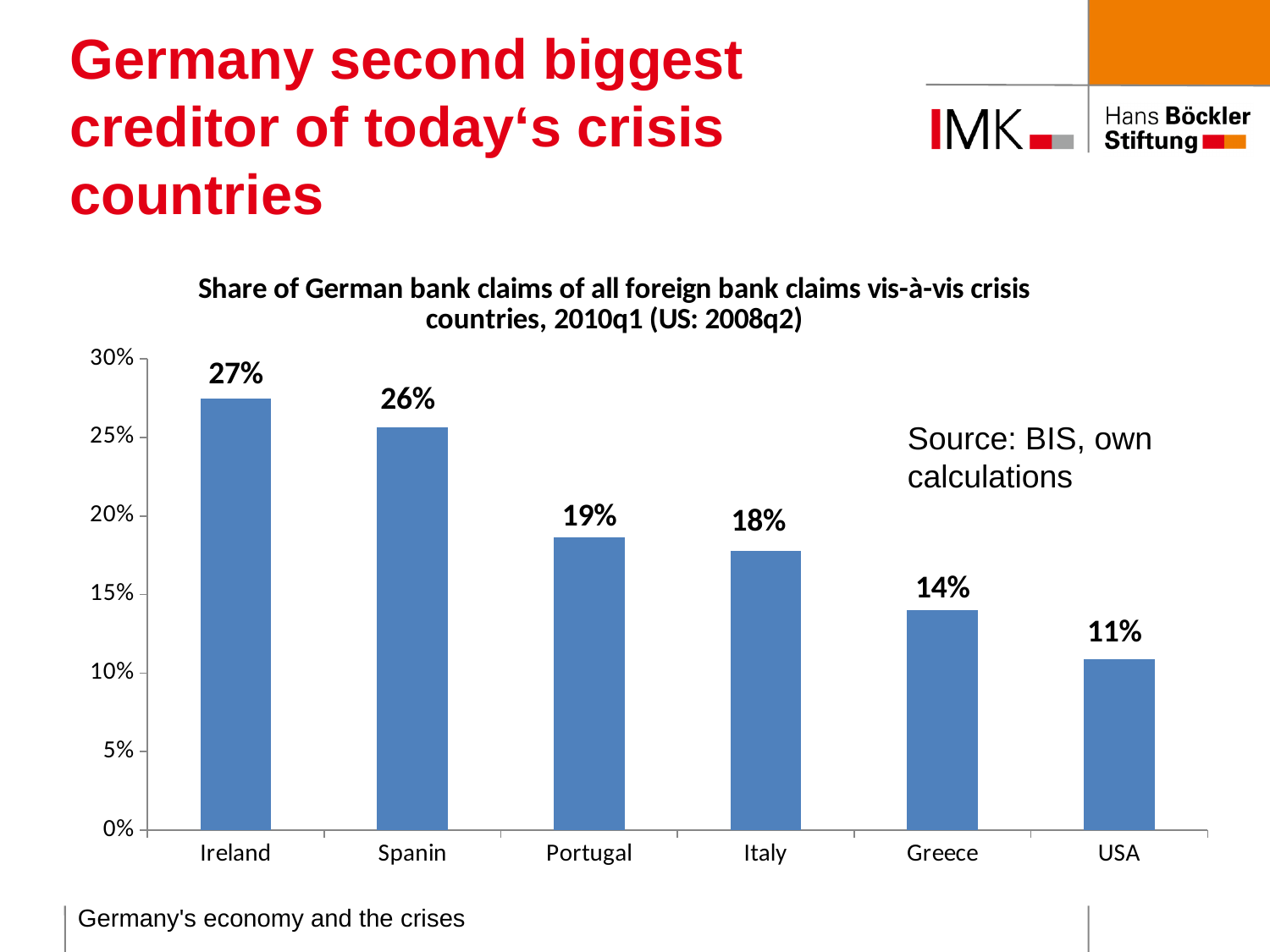
What is the share of German bank claims for Portugal? 19% Which country has the lowest share of German bank claims? USA How many countries are shown in the chart? 6 Is the value for Spain greater or less than 20%? greater What is the difference between the shares for Ireland and Greece? 13% Which country has the highest share of German bank claims? Ireland Which has a larger share of German bank claims, Greece or Italy? Italy What is the title of the chart? Share of German bank claims of all foreign bank claims vis-à-vis crisis countries, 2010q1 (US: 2008q2) What kind of chart is shown on the slide? Bar chart What is the share of German bank claims for Ireland? 27% What is the difference between the shares for Portugal and Italy? 1% What is the share of German bank claims for the USA? 11%